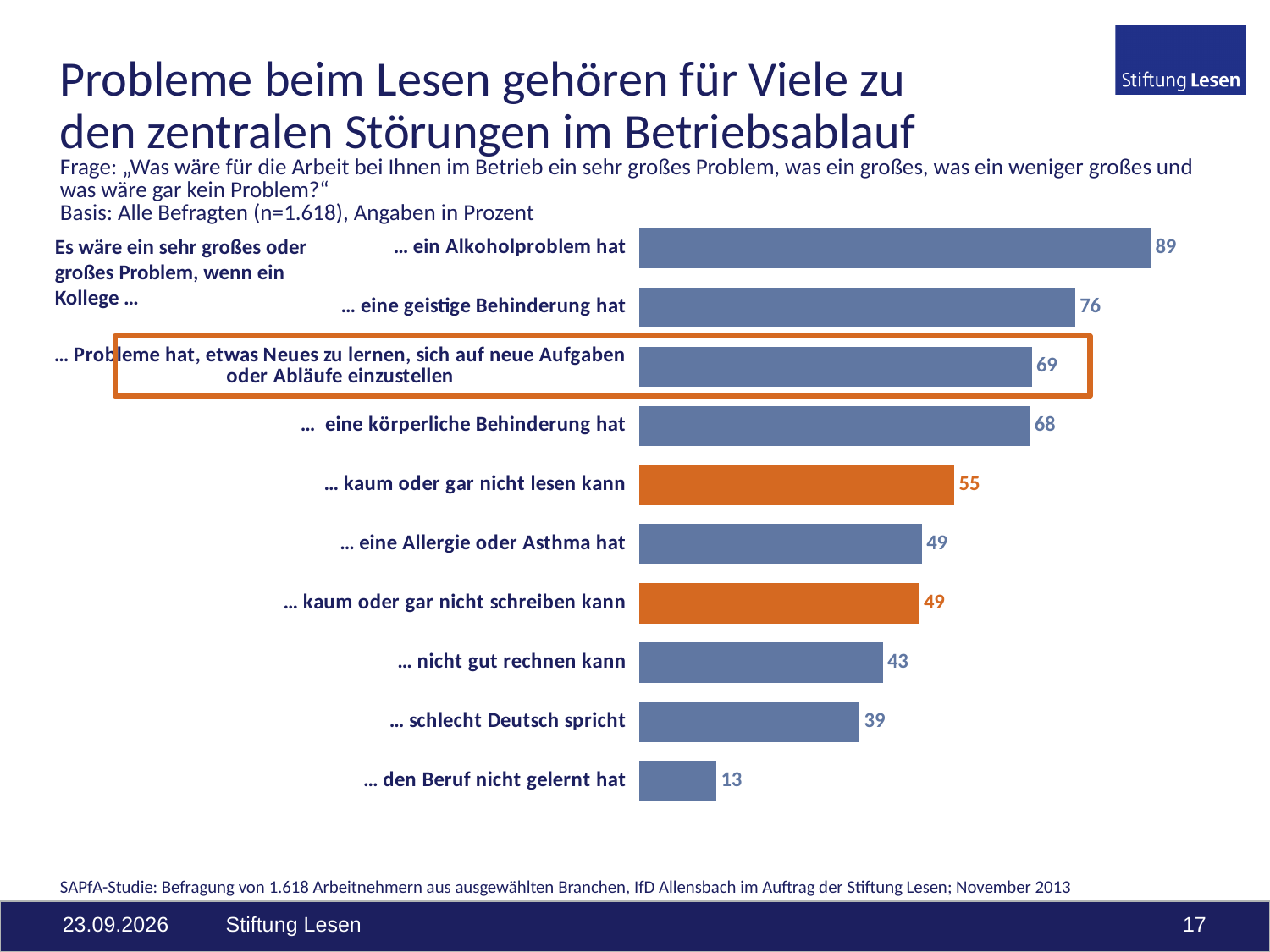
Which category has the lowest value? … den Beruf nicht gelernt hat What is the difference between the values for "… kaum oder gar nicht lesen kann" and "… kaum oder gar nicht schreiben kann"? 6 What is the difference between the values for "… ein Alkoholproblem hat" and "… den Beruf nicht gelernt hat"? 76 What value is shown for "… nicht gut rechnen kann"? 43 Which category has the highest value? … ein Alkoholproblem hat How many categories are shown in the chart? 10 What kind of chart is shown on the slide? Bar chart Which two categories are highlighted with orange bars? … kaum oder gar nicht lesen kann; … kaum oder gar nicht schreiben kann What value is shown for "… ein Alkoholproblem hat"? 89 Which is larger: the value for "… eine geistige Behinderung hat" or for "… eine körperliche Behinderung hat"? … eine geistige Behinderung hat What value is shown for "… kaum oder gar nicht lesen kann"? 55 What value is shown for "… schlecht Deutsch spricht"? 39